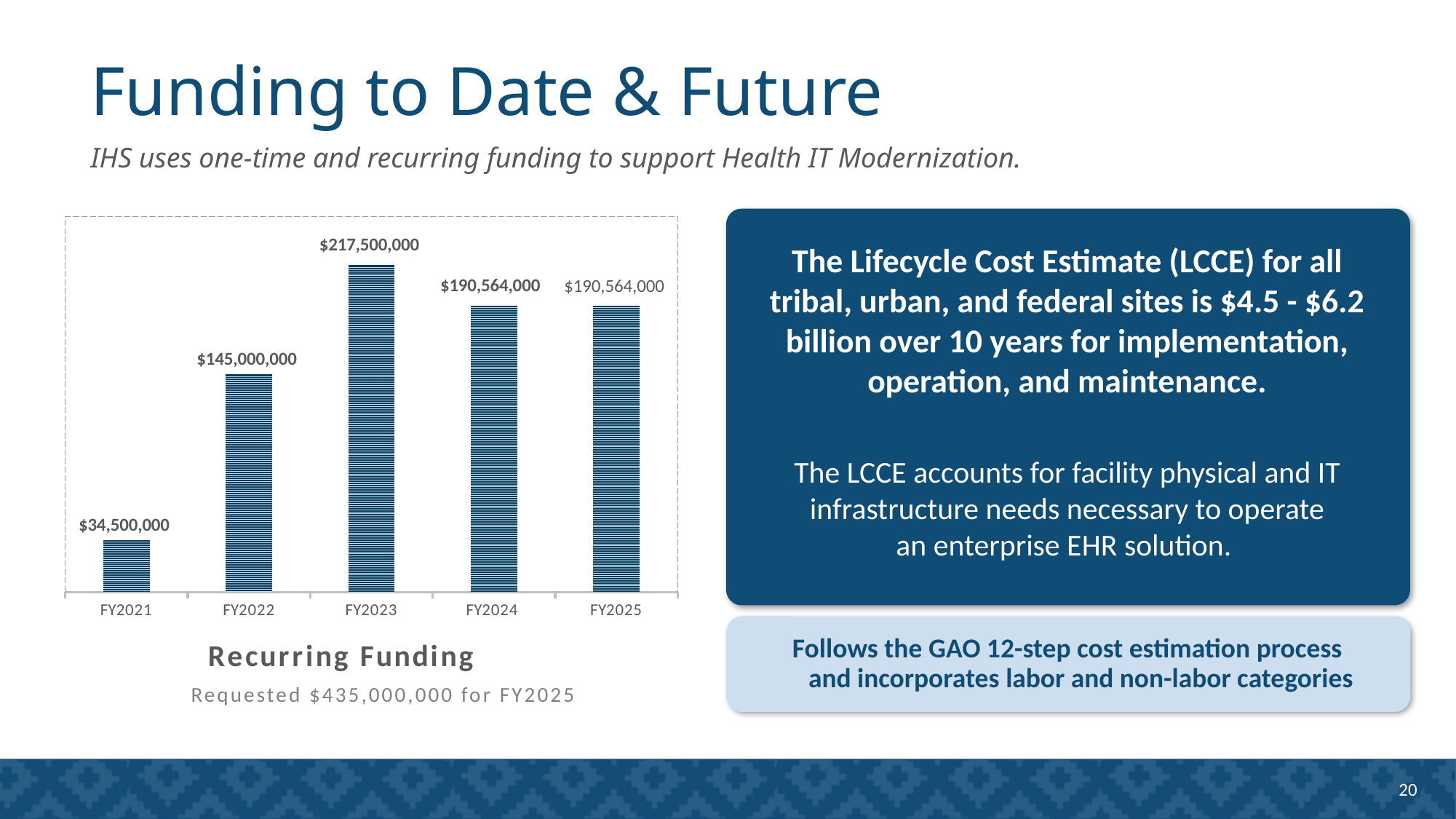
Does the recurring funding rise or fall from FY2021 to FY2023? Rise Which fiscal year has the lowest recurring funding? FY2021 How many fiscal years are shown in the chart? 5 What is the difference between the FY2022 and FY2021 recurring funding values? $110,500,000 What is the recurring funding value for FY2021? $34,500,000 What is the difference between the FY2023 and FY2022 recurring funding values? $72,500,000 What is the recurring funding value for FY2025? $190,564,000 What is the recurring funding value for FY2023? $217,500,000 Which is larger, the recurring funding for FY2022 or FY2024? FY2024 What kind of chart is shown on the slide? Bar chart What is the title of the chart? Recurring Funding Which fiscal year has the highest recurring funding? FY2023